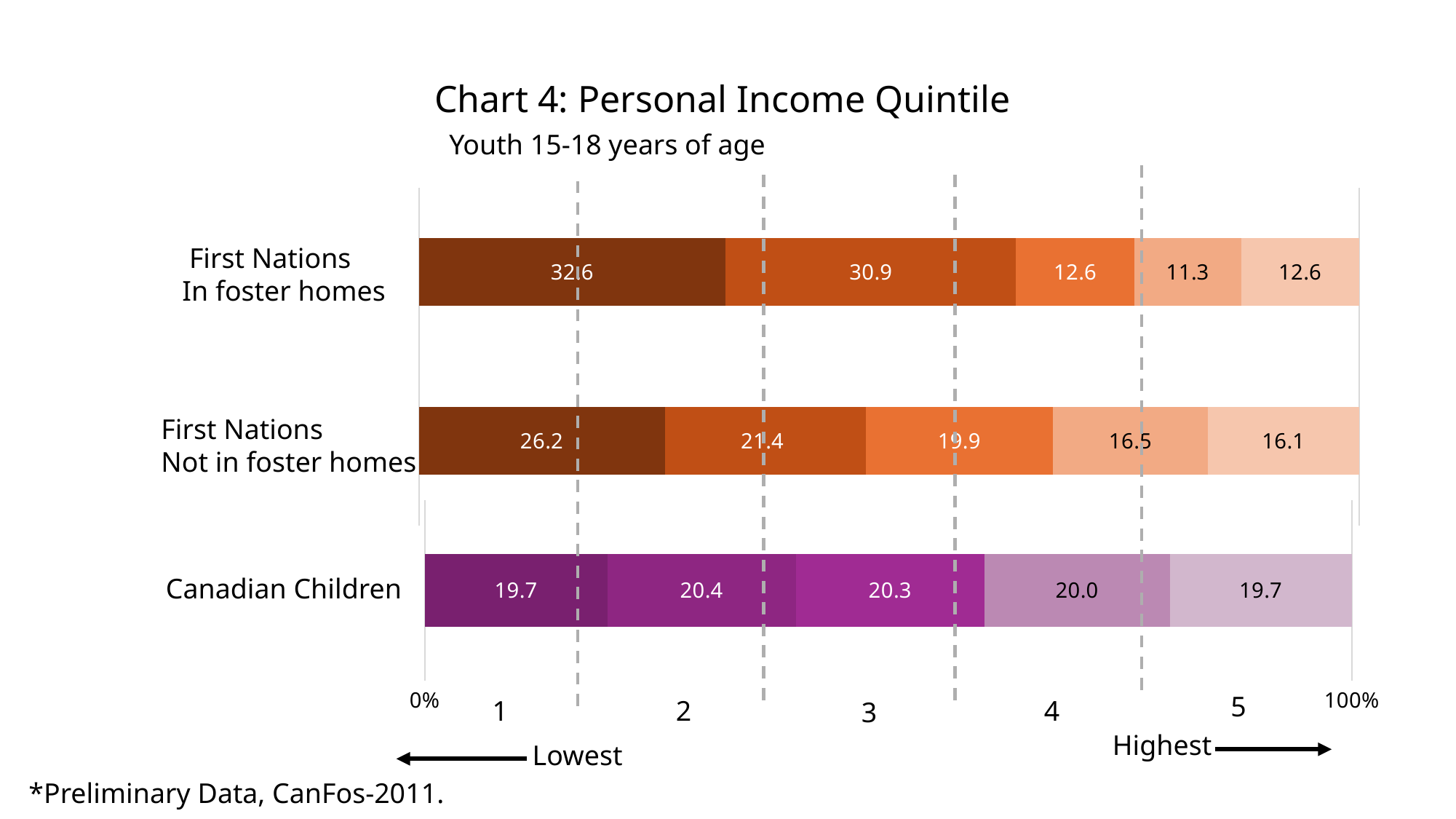
What is the difference between the quintile 1 values for First Nations In foster homes and Canadian Children? 12.9 How many quintile segments make up each bar? 5 How many groups (bars) are shown in the chart? 3 What kind of chart is Chart 4: Personal Income Quintile? stacked bar chart Which quintile has the lowest value for First Nations In foster homes? 4 What is the value for quintile 3 for First Nations Not in foster homes? 19.9 Which quintile has the highest value for First Nations Not in foster homes? 1 What is the value for quintile 5 for Canadian Children? 19.7 What is the value for quintile 4 for First Nations In foster homes? 11.3 What is the value for quintile 1 for First Nations In foster homes? 32.6 Which is larger: the quintile 2 value for First Nations In foster homes or for First Nations Not in foster homes? First Nations In foster homes What age group does the chart subtitle say the data covers? Youth 15-18 years of age